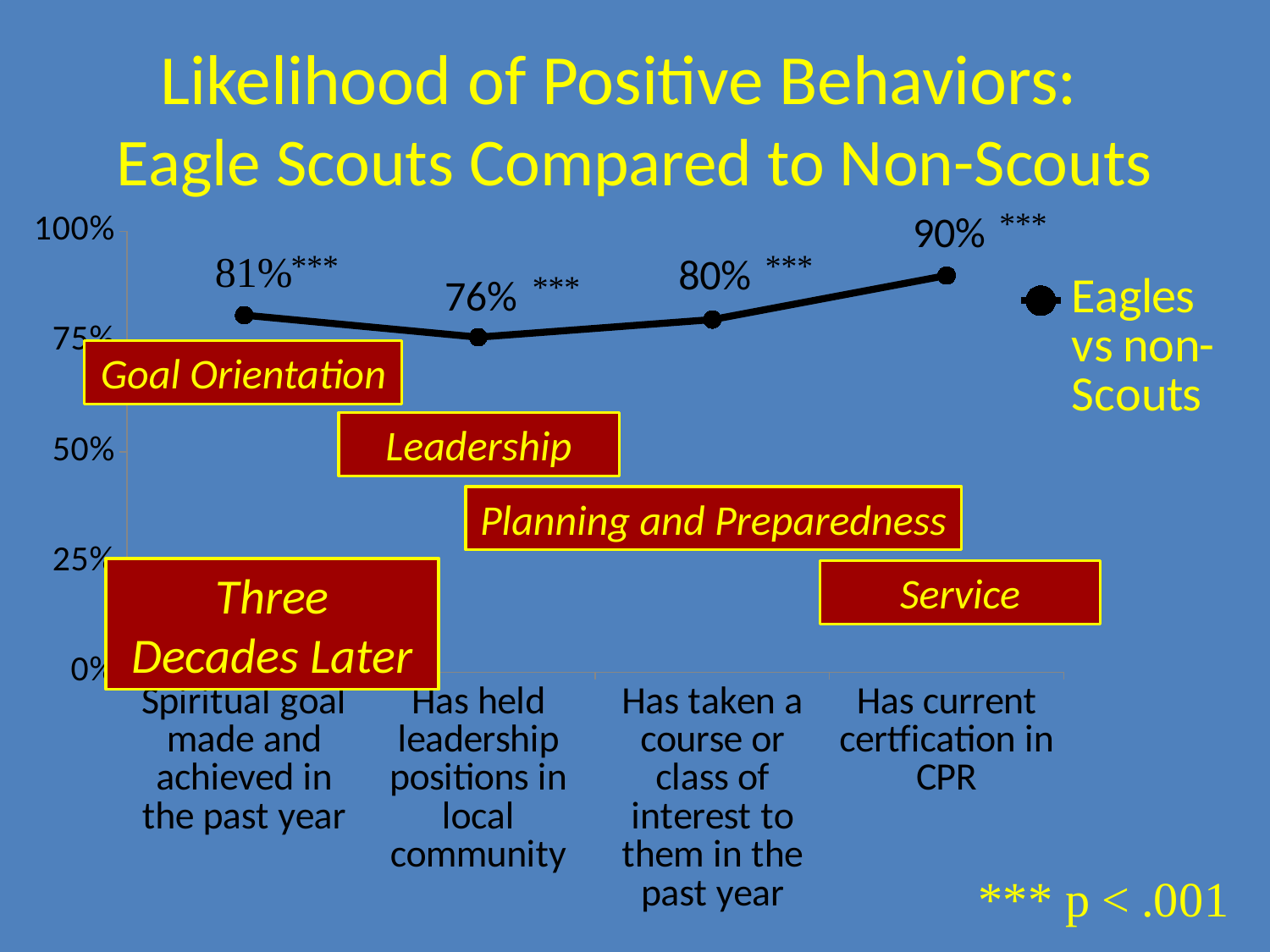
What kind of chart is shown on the slide? line chart What is the value for "Has taken a course or class of interest to them in the past year"? 80% What is the difference between the value for "Has current certfication in CPR" and the value for "Has held leadership positions in local community"? 14% How many series does the legend list? 1 What is the value for "Has current certfication in CPR"? 90% What is the value for "Spiritual goal made and achieved in the past year"? 81% Which is larger: the value for "Spiritual goal made and achieved in the past year" or the value for "Has held leadership positions in local community"? Spiritual goal made and achieved in the past year What is the value for "Has held leadership positions in local community"? 76% How many categories are plotted on the x axis? 4 Which category has the lowest value? Has held leadership positions in local community What is the legend entry for the plotted series? Eagles vs non-Scouts Which category has the highest value? Has current certfication in CPR